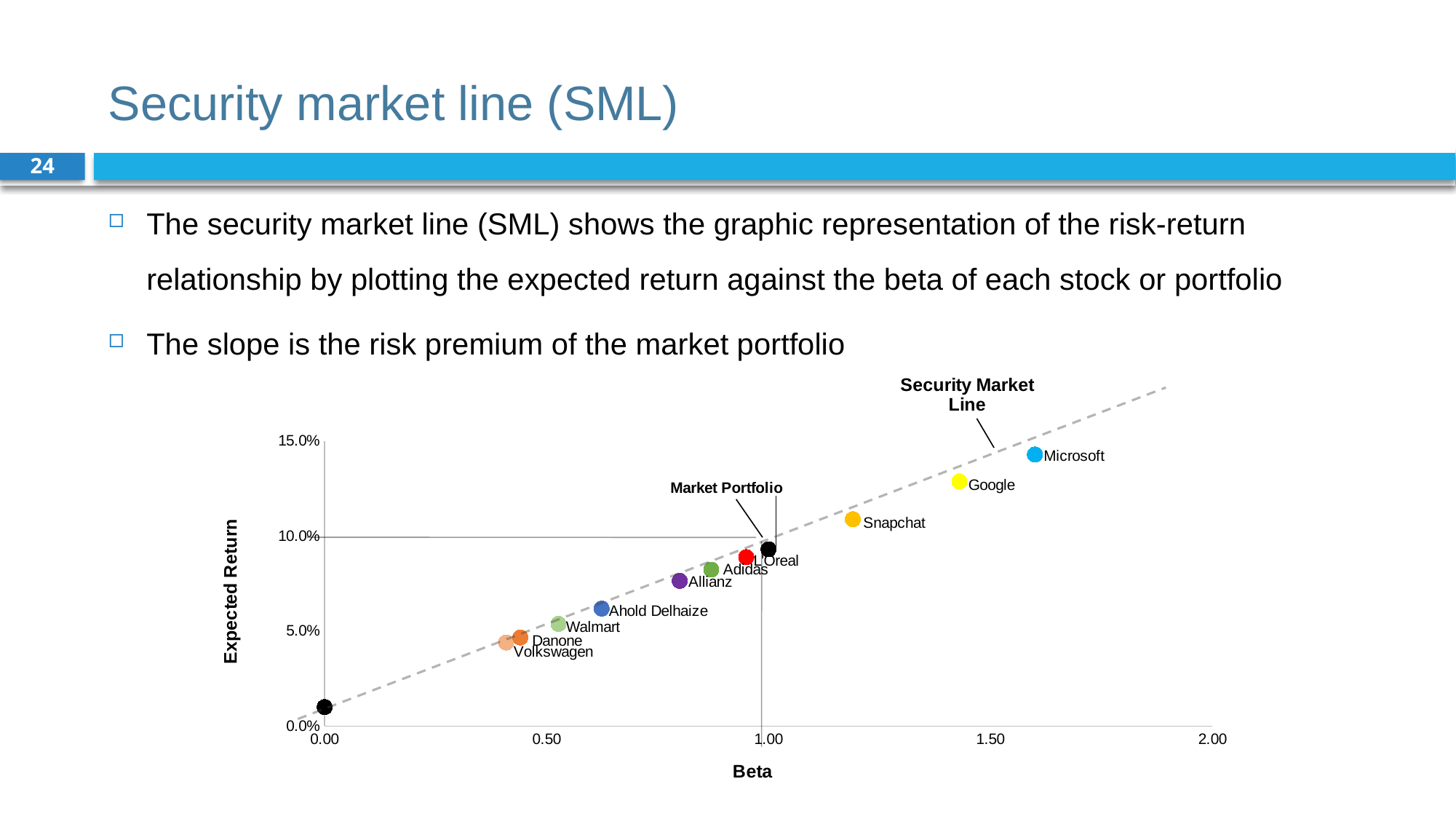
How many named companies are plotted on the chart? 10 What is the label of the x axis of the chart? Beta Is the expected return for Walmart greater or less than 10.0%? less Which labeled company has the lowest expected return on the chart? Volkswagen Is the beta for Microsoft greater or less than 1.50? greater Which has the higher beta, Microsoft or Allianz? Microsoft Which has the higher expected return, Google or Snapchat? Google What kind of chart is shown on the slide? Scatter chart Is the expected return for Microsoft greater or less than 10.0%? greater What is the label of the y axis of the chart? Expected Return Which company has the highest expected return on the chart? Microsoft Does expected return rise or fall as beta increases along the x axis? Rise